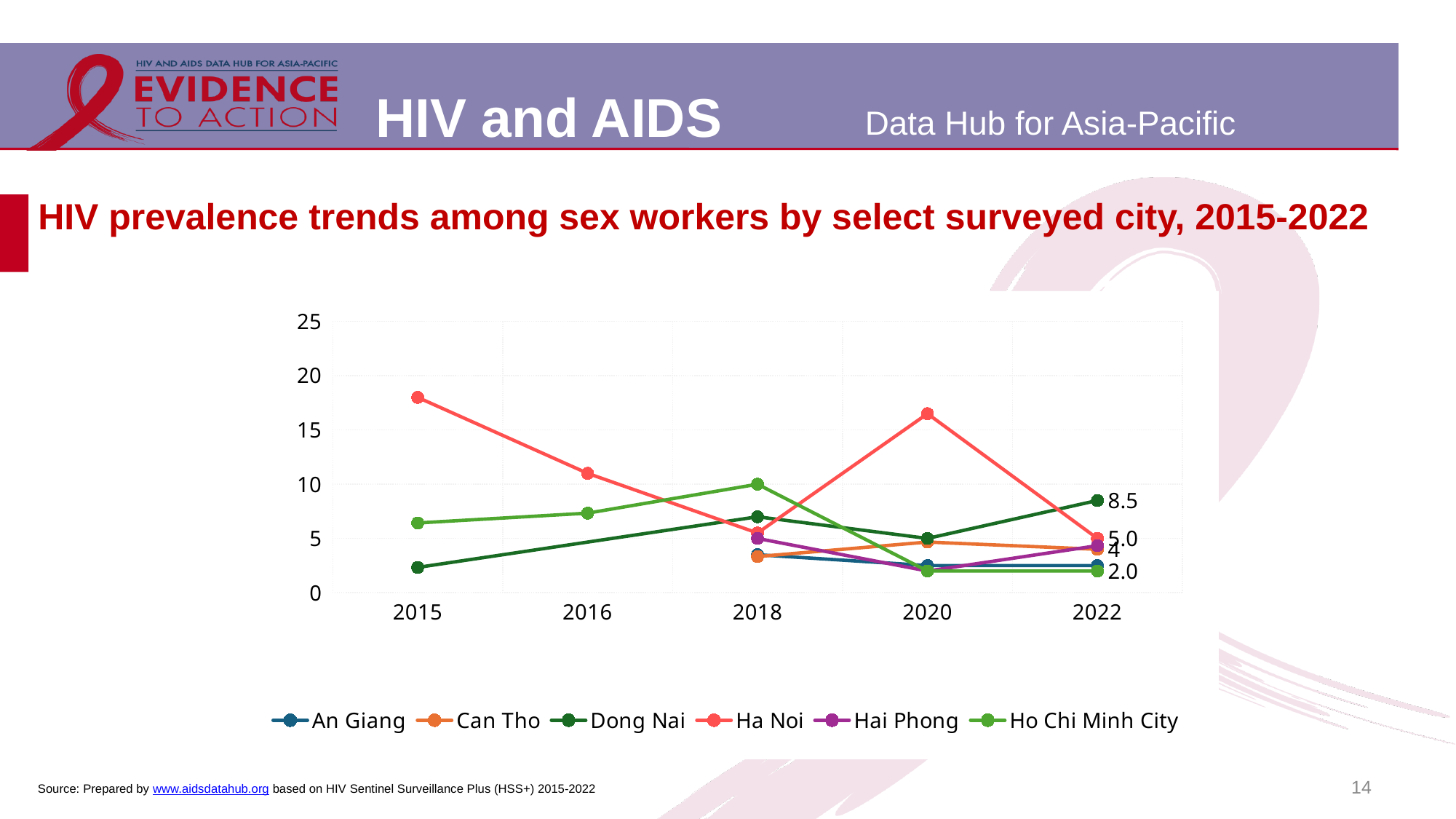
Which city has the highest HIV prevalence in 2015? Ha Noi What is the HIV prevalence value for Dong Nai in 2022? 8.5 How many years are shown on the x axis? 5 Which city has the highest HIV prevalence in 2022? Dong Nai Is the value for Dong Nai in 2015 greater or less than 5? less Is the value for Ha Noi in 2015 greater or less than 15? greater Does the Ha Noi line rise or fall from 2015 to 2018? fall Which city has the lowest HIV prevalence in 2015? Dong Nai How many series does the legend list? 6 What type of chart is shown on the slide? line chart Which is larger in 2022, the value for Dong Nai or the value for Ha Noi? Dong Nai What is the HIV prevalence value for Ha Noi in 2022? 5.0